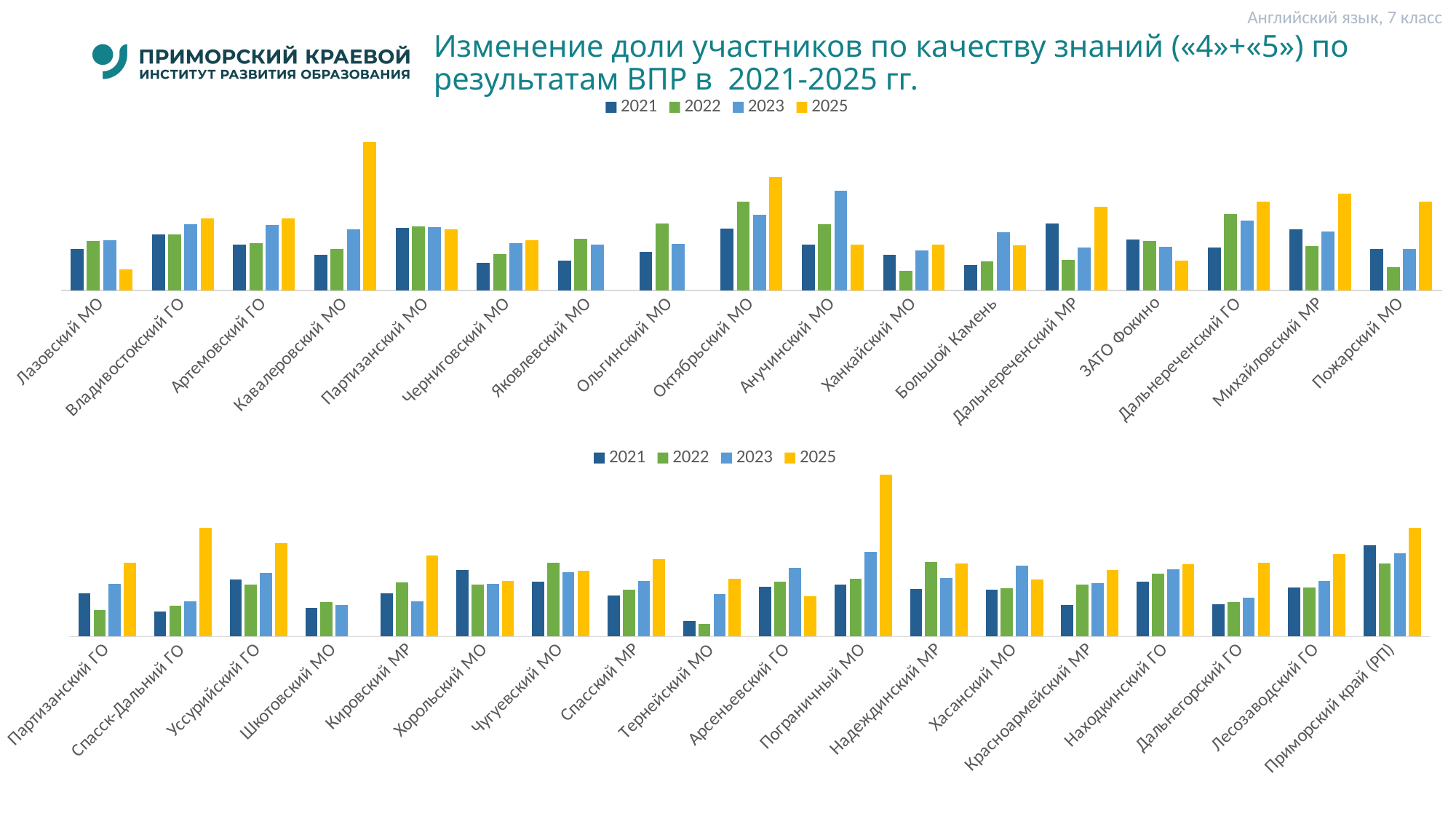
Which colour represents the 2025 series in both charts? yellow In the bottom chart, for Приморский край (РП), which is larger: the 2021 value or the 2022 value? 2021 In the bottom chart, for Тернейский МО, which is larger: the 2021 value or the 2023 value? 2023 In the top chart, which years are listed in the legend? 2021, 2022, 2023, 2025 How many categories (municipalities) are shown on the x axis of the top chart? 17 In the top chart, which category has the tallest 2025 bar? Кавалеровский МО In the top chart, which category has the lowest 2022 bar? Ханкайский МО How many series does the legend of the top chart list? 4 In the top chart, for Лазовский МО, which is larger: the 2021 value or the 2025 value? 2021 In the bottom chart, which category has the tallest 2025 bar? Пограничный МО How many categories are shown on the x axis of the bottom chart? 18 What kind of chart is the top chart on the slide? bar chart